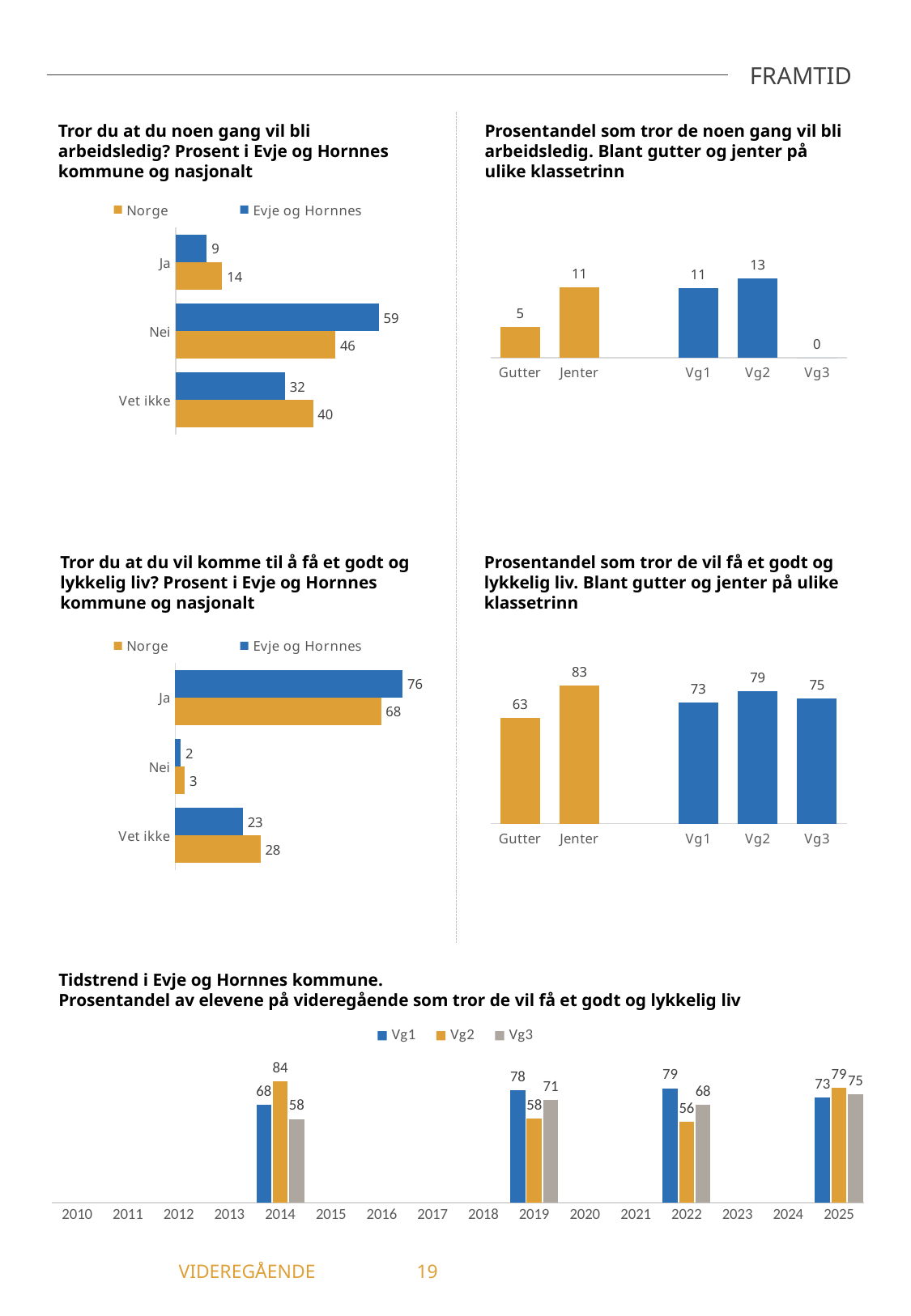
In the bottom chart 'Tidstrend i Evje og Hornnes kommune', what is the value for Vg2 in 2014? 84 In the top-left chart 'Tror du at du noen gang vil bli arbeidsledig?', how many series does the legend list? 2 In the middle-left chart 'Tror du at du vil komme til å få et godt og lykkelig liv?', what is the value for Norge for 'Nei'? 3 In the top-left chart 'Tror du at du noen gang vil bli arbeidsledig?', what is the difference between Norge and Evje og Hornnes for 'Vet ikke'? 8 In the top-left chart 'Tror du at du noen gang vil bli arbeidsledig?', what is the value for Evje og Hornnes for 'Nei'? 59 In the middle-left chart 'Tror du at du vil komme til å få et godt og lykkelig liv?', which is larger for 'Ja': Norge or Evje og Hornnes? Evje og Hornnes In the middle-right chart 'Prosentandel som tror de vil få et godt og lykkelig liv', which category has the lowest value? Gutter What kind of chart is the middle-left chart 'Tror du at du vil komme til å få et godt og lykkelig liv?'? Bar chart In the top-right chart 'Prosentandel som tror de noen gang vil bli arbeidsledig', which category has the highest value? Vg2 In the bottom chart 'Tidstrend i Evje og Hornnes kommune', how many years have data plotted? 4 In the middle-right chart 'Prosentandel som tror de vil få et godt og lykkelig liv', what is the difference between Jenter and Gutter? 20 In the top-right chart 'Prosentandel som tror de noen gang vil bli arbeidsledig', what is the value for Vg3? 0